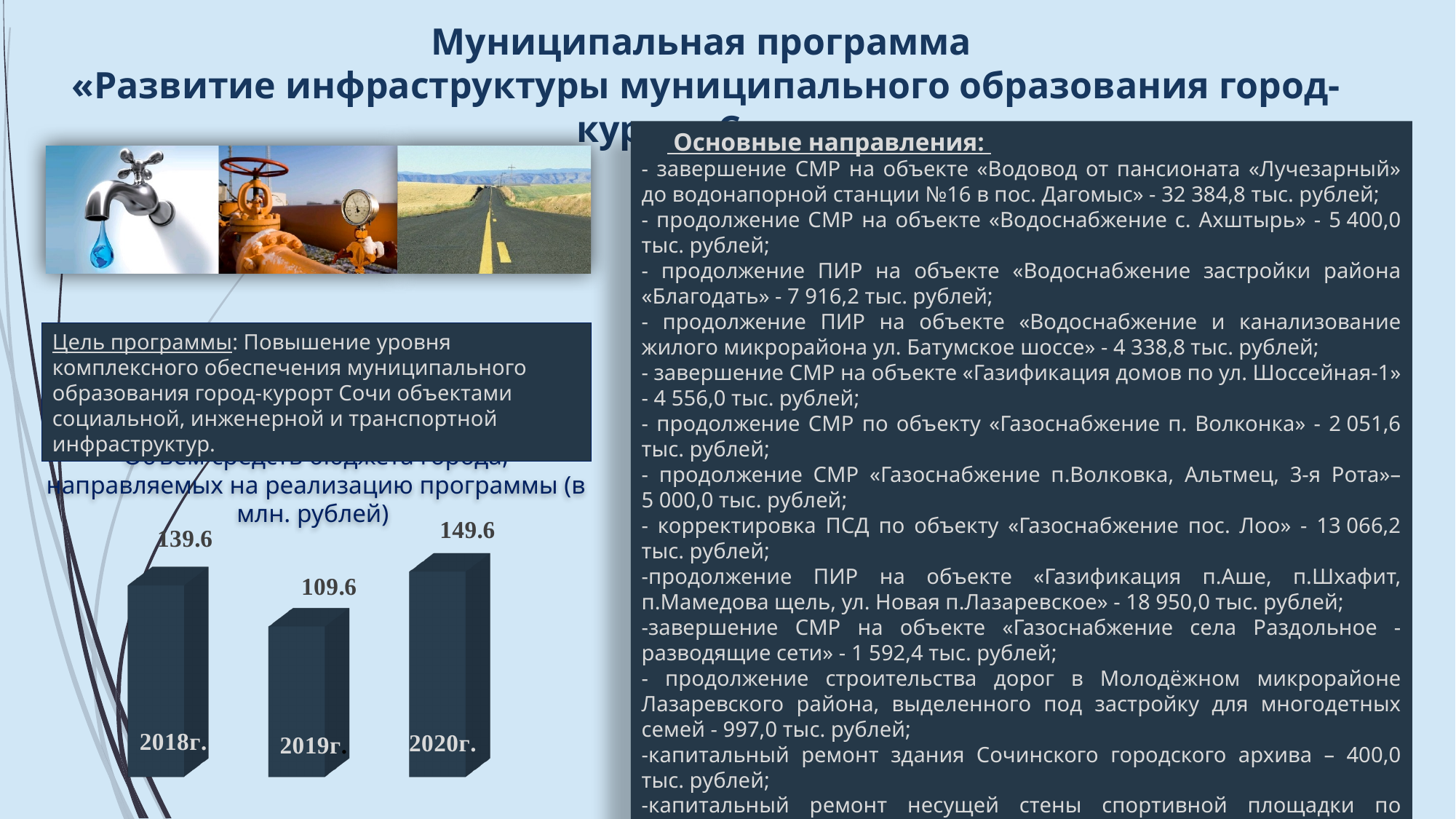
In what units are the values in the bar chart expressed, according to its title? млн. рублей What is the value for 2018г. in the bar chart? 139.6 Which is larger in the bar chart, the value for 2018г. or the value for 2020г.? 2020г. Which year has the highest value in the bar chart? 2020г. What is the difference between the values for 2018г. and 2019г. in the bar chart? 30.0 Which year has the lowest value in the bar chart? 2019г. Does the value fall or rise from 2019г. to 2020г. in the bar chart? rise What kind of chart is shown on the slide? bar chart How many bars are shown in the chart? 3 What is the difference between the values for 2020г. and 2019г. in the bar chart? 40.0 What is the value for 2020г. in the bar chart? 149.6 What is the value for 2019г. in the bar chart? 109.6